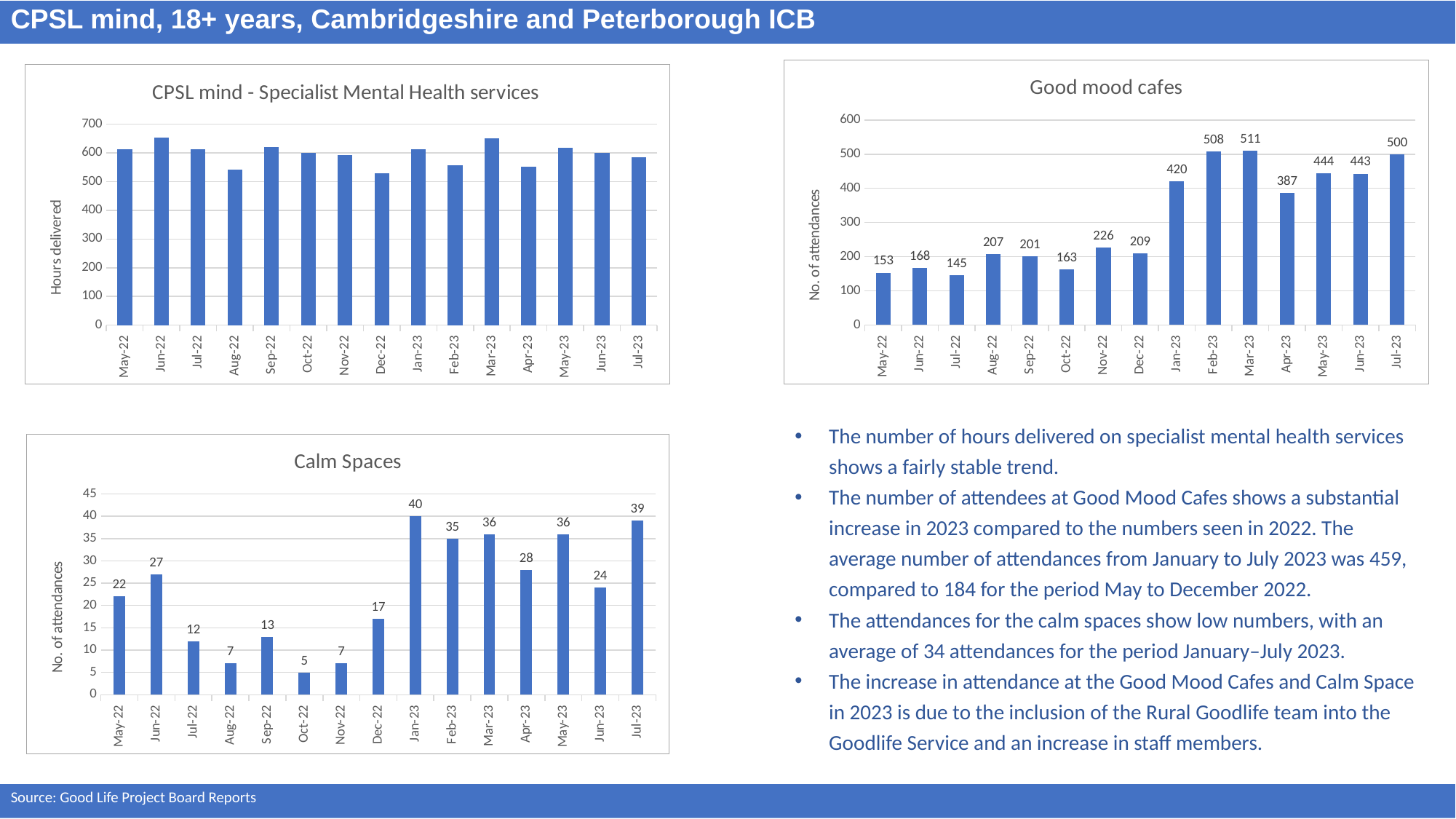
In the Calm Spaces chart, what is the difference between the Jul-23 and Jun-23 values? 15 In the CPSL mind - Specialist Mental Health services chart, is the value for Jun-22 greater or less than 600? greater In the Good mood cafes chart, which month has the lowest number of attendances? Jul-22 In the Calm Spaces chart, which is larger, the value for Jun-22 or the value for Apr-23? Apr-23 In the Good mood cafes chart, how many attendances were there in Feb-23? 508 In the CPSL mind - Specialist Mental Health services chart, is the value for Aug-22 greater or less than 600? less How many months are plotted in the Calm Spaces chart? 15 In the Good mood cafes chart, what is the difference in attendances between Jan-23 and Dec-22? 211 What type of chart is the Good mood cafes chart? Bar chart In the Good mood cafes chart, which month has the highest number of attendances? Mar-23 In the Calm Spaces chart, which month has the lowest number of attendances? Oct-22 In the Calm Spaces chart, how many attendances were there in Jan-23? 40